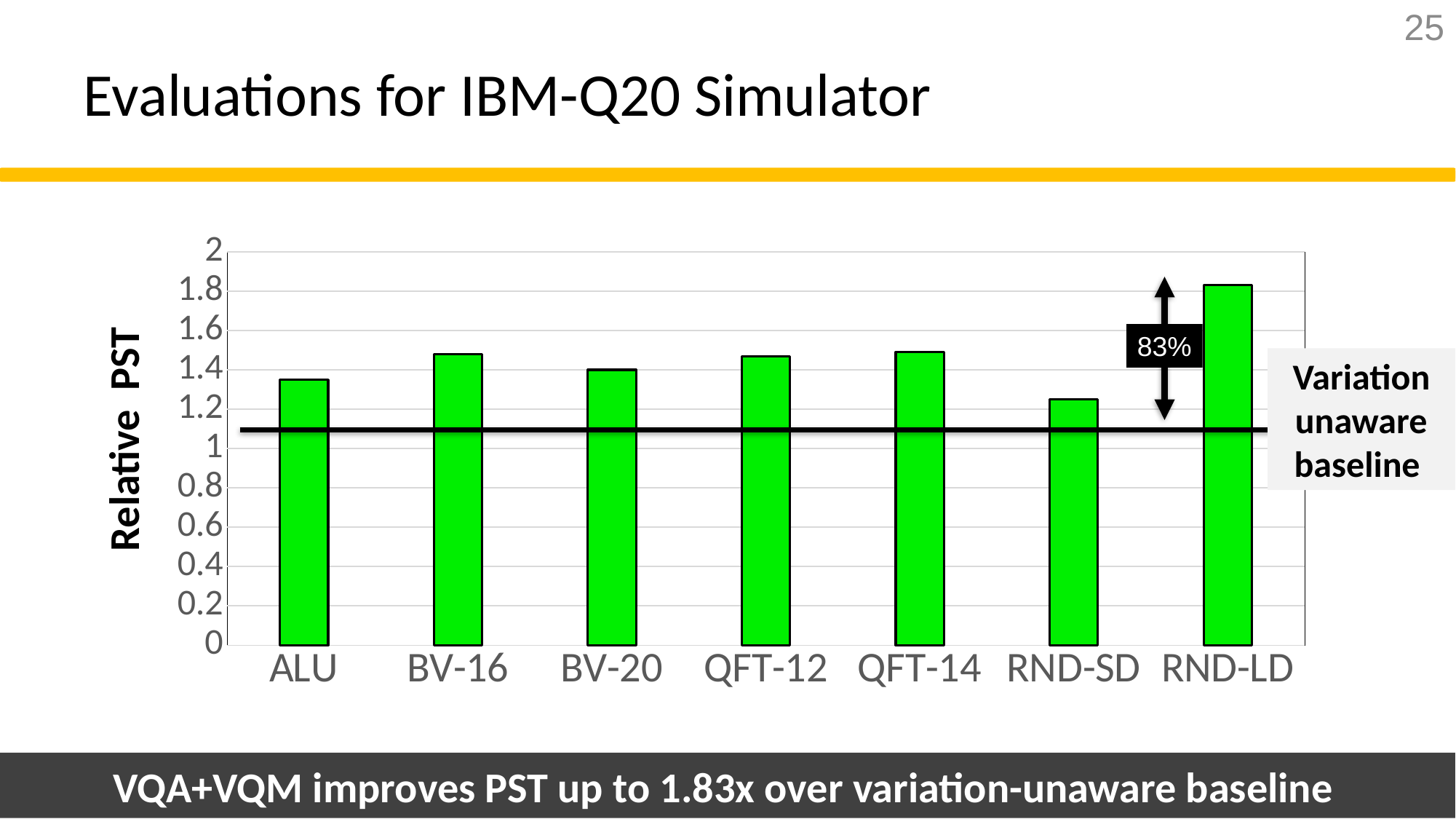
What percentage improvement is annotated next to the RND-LD bar? 83% Which benchmark has the lowest Relative PST? RND-SD What is the label on the y axis of the chart? Relative PST Is the Relative PST for RND-LD greater or less than 1.6? greater How many categories (benchmarks) are plotted on the x axis? 7 What kind of chart is shown on the slide? bar chart Which has a higher Relative PST, BV-16 or RND-SD? BV-16 Which has a higher Relative PST, RND-LD or ALU? RND-LD Is the Relative PST for ALU greater or less than 1.2? greater Is the Relative PST for BV-20 greater or less than 1.6? less Which benchmark has the highest Relative PST? RND-LD